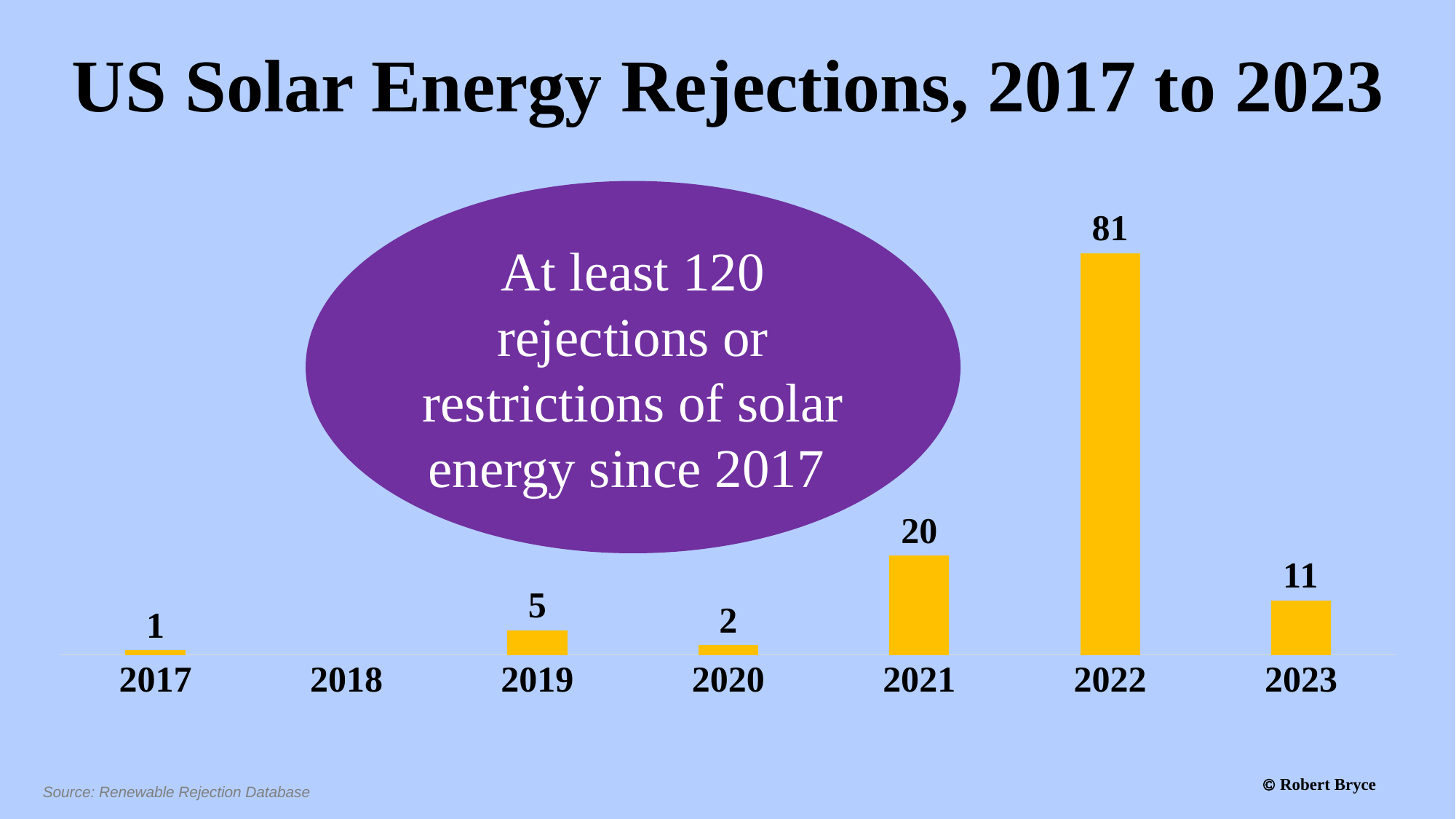
What is the value for 2019? 5 Which year has the highest value? 2022 What is the value for 2021? 20 What is the value for 2023? 11 What kind of chart is shown on the slide? Bar chart What is the difference between the values for 2022 and 2021? 61 Which is larger, the value for 2019 or the value for 2020? 2019 How many years are shown on the x axis? 7 Which is larger, the value for 2021 or the value for 2023? 2021 What is the difference between the values for 2023 and 2020? 9 What is the value for 2022? 81 What is the title of the chart? US Solar Energy Rejections, 2017 to 2023